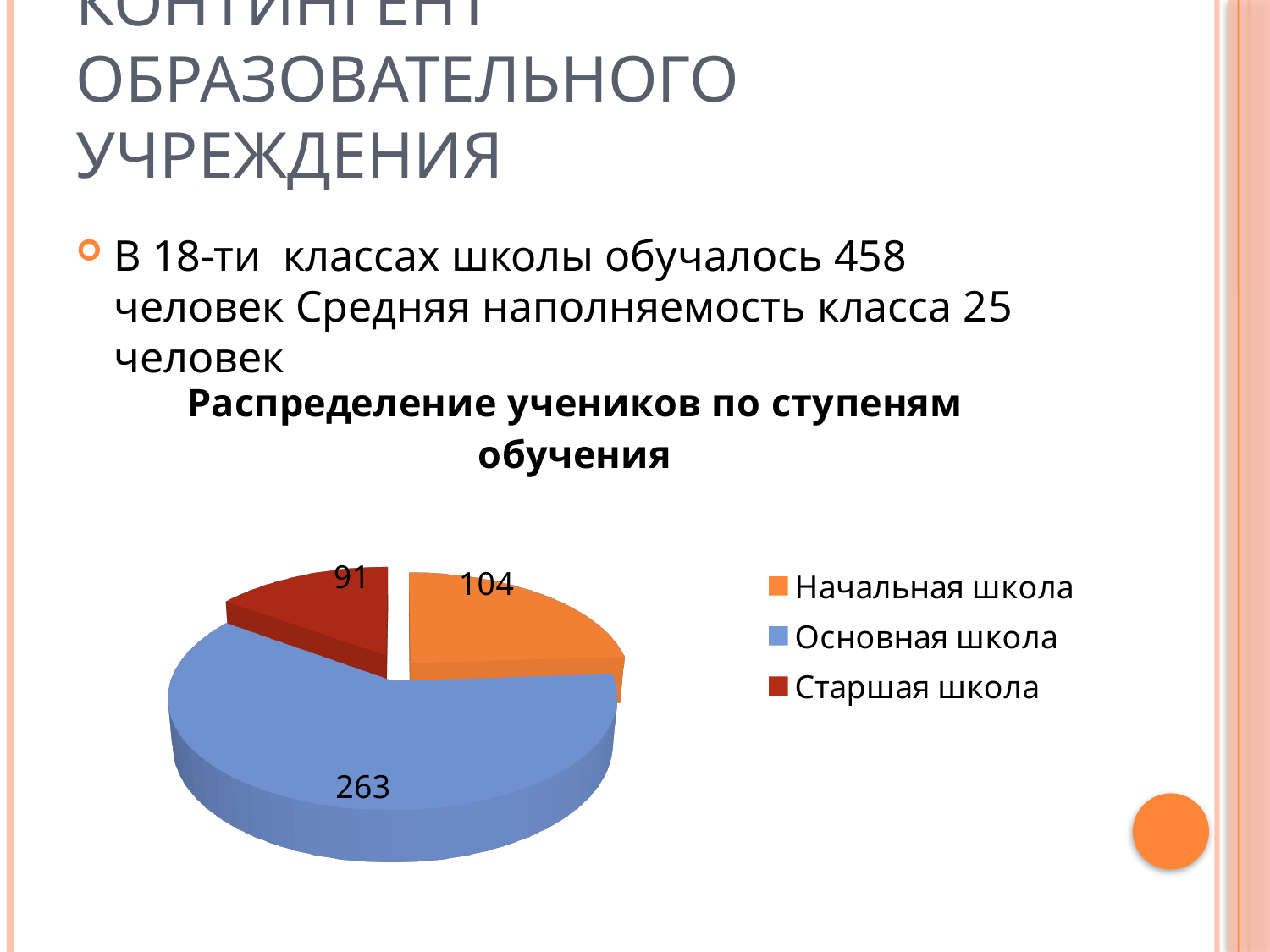
What is the value for Старшая школа? 91 Which category has the smallest slice? Старшая школа Which is larger, the value for Начальная школа or the value for Старшая школа? Начальная школа What is the value for Основная школа? 263 What kind of chart is shown on the slide? pie chart What is the title of the chart? Распределение учеников по ступеням обучения What is the difference between the values for Основная школа and Начальная школа? 159 How many slices does the pie chart have? 3 What is the value for Начальная школа? 104 Which category has the largest slice? Основная школа What is the total of all three slices? 458 How many entries does the legend list? 3